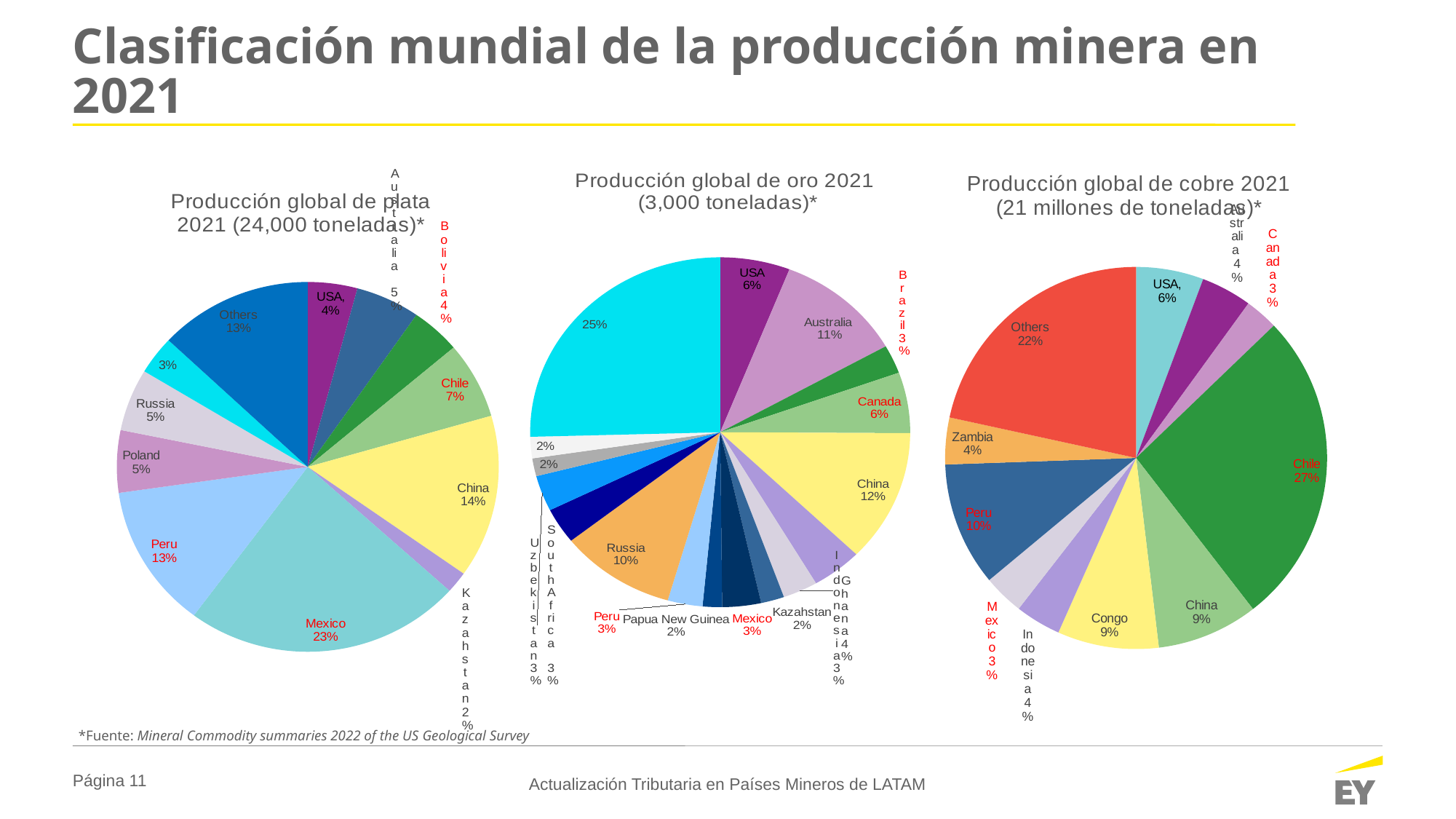
According to the title of the gold production chart, what was the total global gold production in 2021? 3,000 toneladas In the gold production chart (Producción global de oro 2021), what share does Russia have? 10% In the copper production chart (Producción global de cobre 2021), what share does Peru have? 10% In the silver production chart (Producción global de plata 2021), what share does Mexico have? 23% What kind of chart is used for the three charts on the slide? Pie chart In the silver production chart (Producción global de plata 2021), what is the difference between China's share and Peru's share? 1% In the silver production chart (Producción global de plata 2021), what share does Chile have? 7% In the copper production chart (Producción global de cobre 2021), what is the difference between Chile's share and the Others share? 5% In the copper production chart (Producción global de cobre 2021), which country has the largest share? Chile In the gold production chart (Producción global de oro 2021), what share does Canada have? 6% In the silver production chart (Producción global de plata 2021), which country has the largest share? Mexico In the gold production chart (Producción global de oro 2021), which is larger, China's share or Australia's share? China